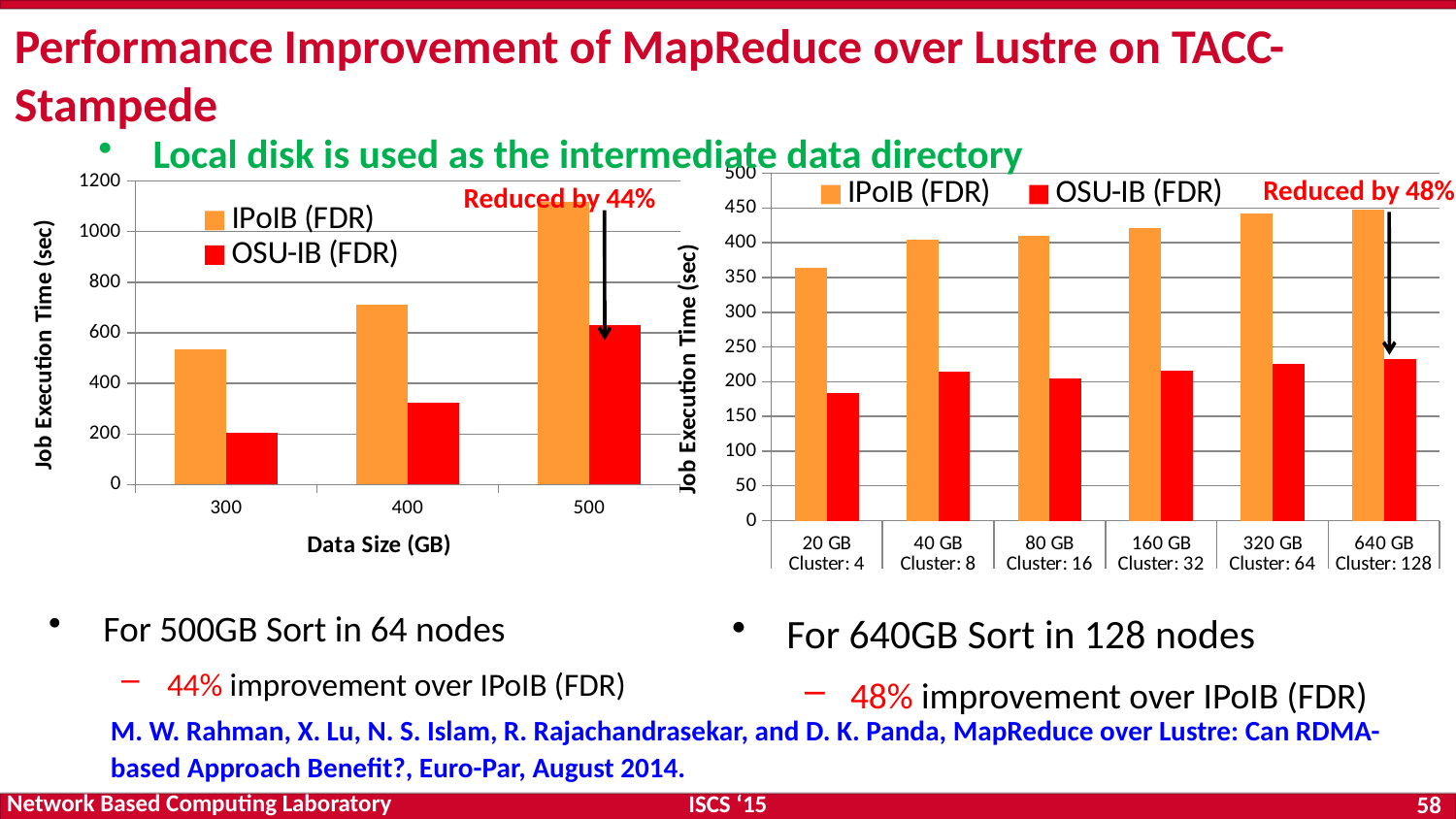
How many series does the legend of the right chart list? 2 How many categories are shown on the x axis of the right chart? 6 In the right chart, which category has the lowest OSU-IB (FDR) job execution time? 20 GB Cluster: 4 How many data size categories are shown on the x axis of the left chart? 3 In the right chart, is the IPoIB (FDR) value for 20 GB Cluster: 4 greater or less than 400? less What kind of chart is the left chart (Data Size (GB) on the x axis)? bar chart In the left chart, is the OSU-IB (FDR) value for 300 GB greater or less than 400? less In the left chart, which data size has the highest IPoIB (FDR) job execution time? 500 What is the y-axis label of the right chart? Job Execution Time (sec) In the left chart, is the IPoIB (FDR) value for 500 GB greater or less than 1000? greater In the left chart, do the IPoIB (FDR) values rise or fall as data size increases from 300 to 500 GB? rise